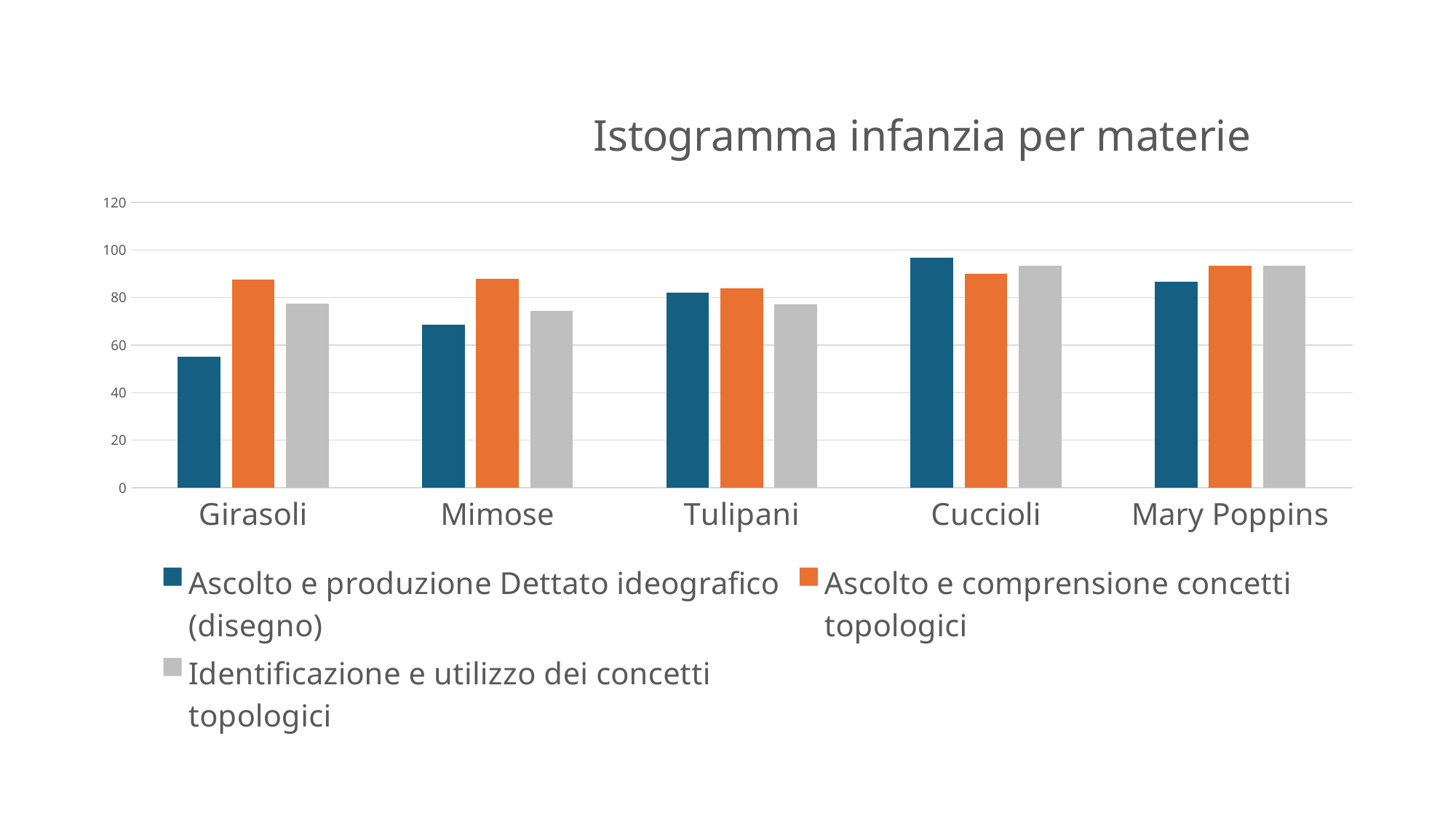
What is the title of the chart? Istogramma infanzia per materie How many series does the legend list? 3 For Girasoli, which series has the larger value: 'Ascolto e produzione Dettato ideografico (disegno)' or 'Ascolto e comprensione concetti topologici'? Ascolto e comprensione concetti topologici What type of chart is shown on the slide? bar chart Which category has the highest value for the series 'Ascolto e produzione Dettato ideografico (disegno)'? Cuccioli How many categories are shown on the x axis? 5 For Cuccioli, which series has the larger value: 'Ascolto e produzione Dettato ideografico (disegno)' or 'Ascolto e comprensione concetti topologici'? Ascolto e produzione Dettato ideografico (disegno) Is the value for Cuccioli in the series 'Ascolto e produzione Dettato ideografico (disegno)' greater or less than 80? greater Is the value for Mimose in the series 'Ascolto e produzione Dettato ideografico (disegno)' greater or less than 60? greater Is the value for Mimose in the series 'Ascolto e comprensione concetti topologici' greater or less than 80? greater Which category has the lowest value for the series 'Ascolto e produzione Dettato ideografico (disegno)'? Girasoli